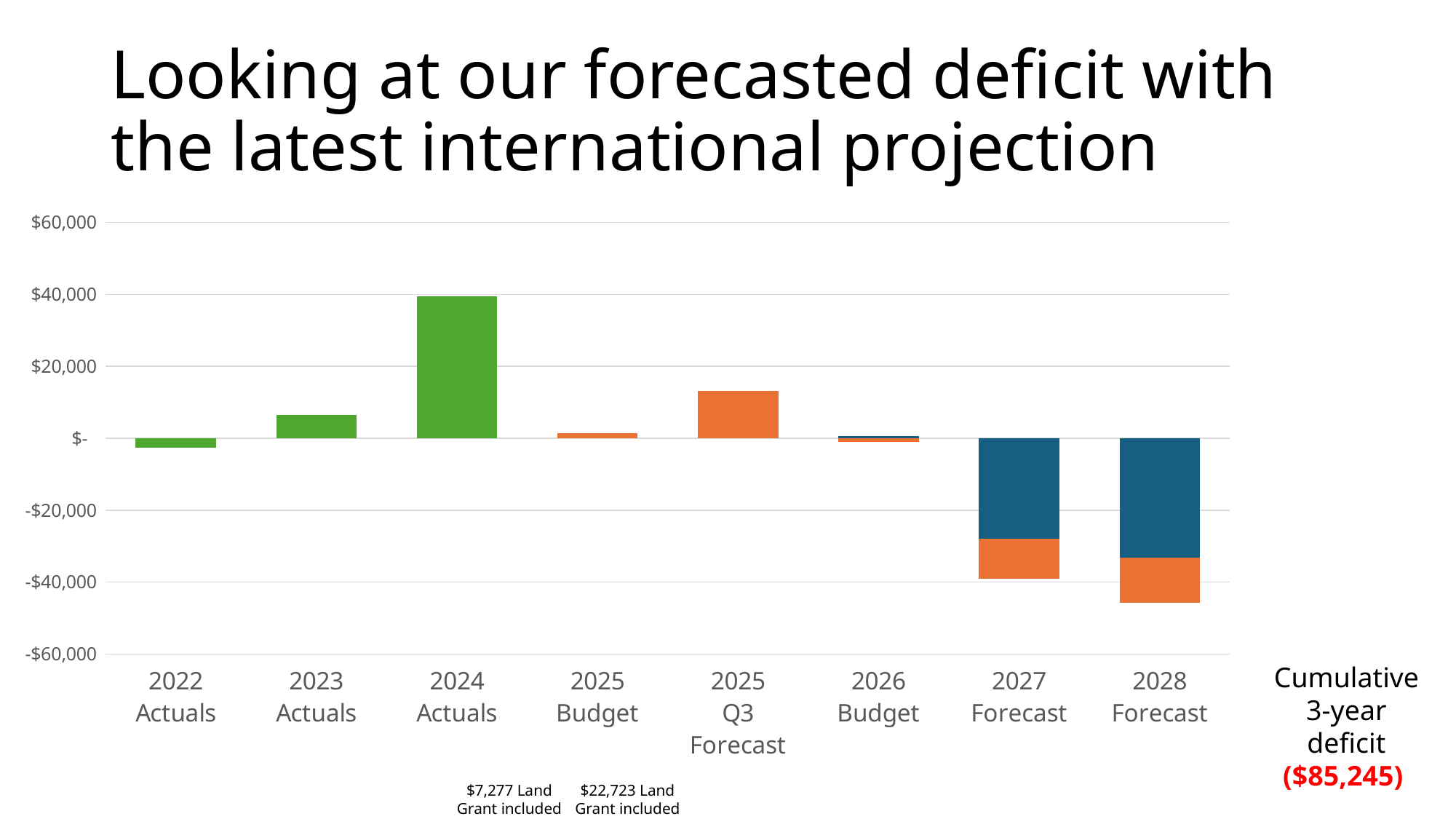
Which is larger, the value for 2025 Q3 Forecast or the value for 2025 Budget? 2025 Q3 Forecast What is the title of the slide containing the chart? Looking at our forecasted deficit with the latest international projection Is the value for 2025 Q3 Forecast greater or less than $20,000? less What kind of chart is shown on the slide? bar chart Is the value for 2028 Forecast greater or less than -$40,000? less Is the value for 2024 Actuals greater or less than $20,000? greater Which is larger, the value for 2024 Actuals or the value for 2023 Actuals? 2024 Actuals How many categories are shown along the x axis of the chart? 8 What cumulative 3-year deficit is stated next to the chart? ($85,245) Which category has the highest value in the chart? 2024 Actuals Which category has the lowest value in the chart? 2028 Forecast